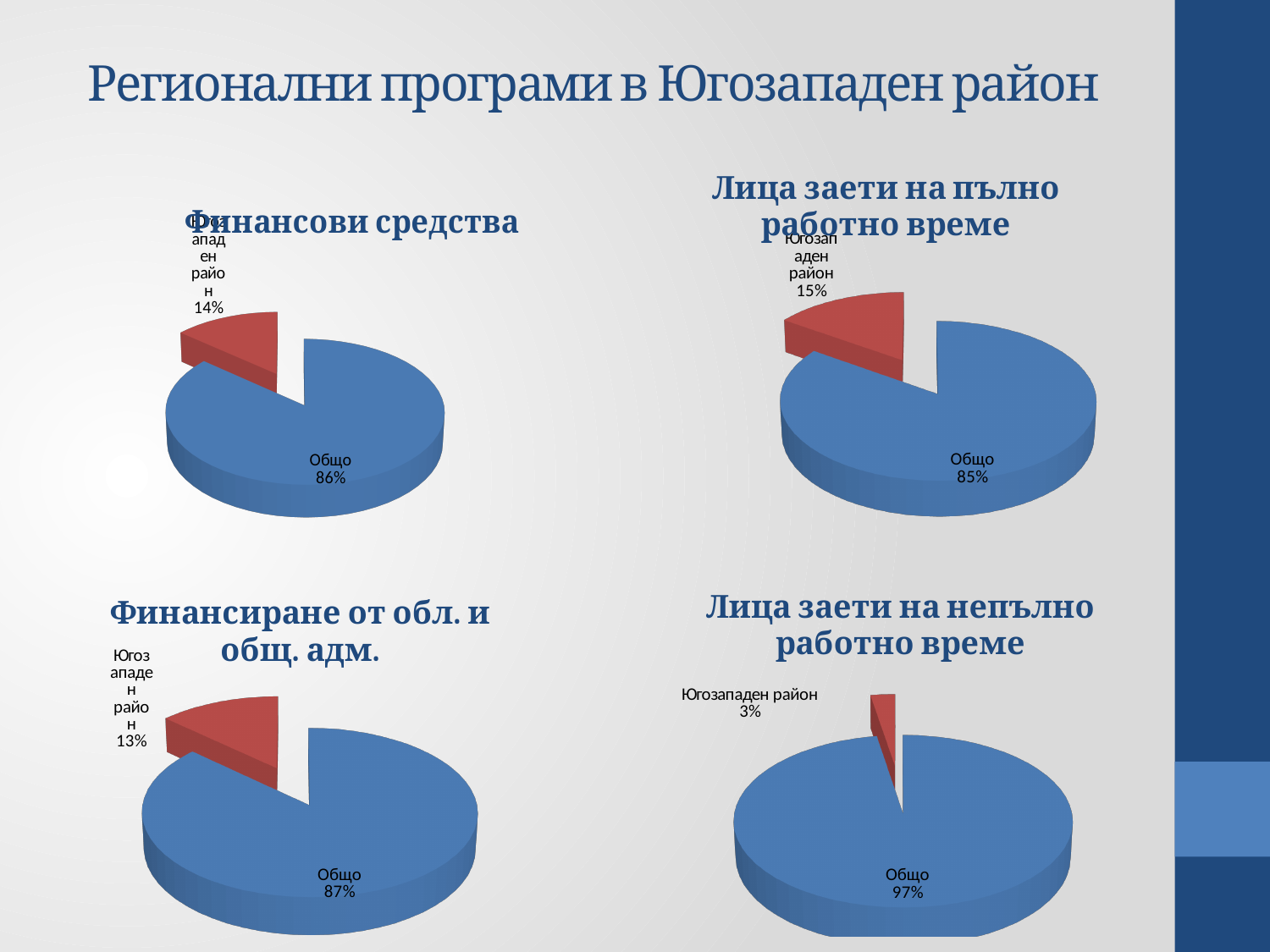
In the chart titled "Финансови средства", what share does "Югозападен район" have? 14% In the chart titled "Финансови средства", what is the value shown for "Общо"? 86% In the chart titled "Лица заети на пълно работно време", what share does "Югозападен район" have? 15% In the chart titled "Лица заети на пълно работно време", what is the value shown for "Общо"? 85% What kind of chart is the chart titled "Лица заети на пълно работно време"? Pie chart In the chart titled "Финансови средства", what is the difference between the "Общо" and "Югозападен район" values? 72% In the chart titled "Лица заети на непълно работно време", which slice is the largest? Общо In the chart titled "Лица заети на непълно работно време", what is the value shown for "Общо"? 97% In the chart titled "Финансиране от обл. и общ. адм.", what share does "Югозападен район" have? 13% How many charts are shown on the slide? 4 In the chart titled "Финансиране от обл. и общ. адм.", what is the value shown for "Общо"? 87%